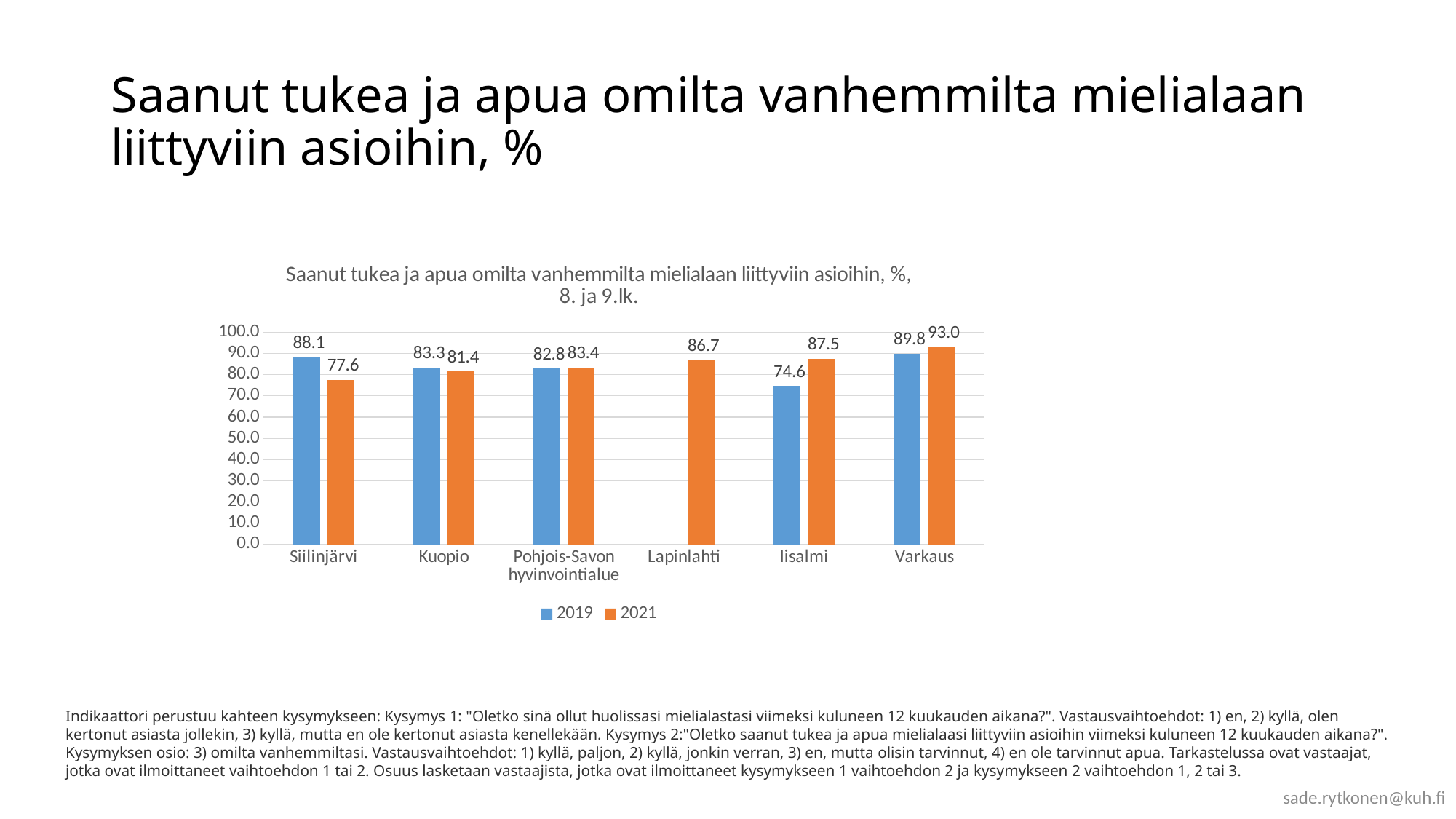
What is the difference between the 2021 and 2019 values for Iisalmi? 12.9 Which category has only a 2021 bar and no 2019 bar? Lapinlahti Which is larger for Kuopio, the 2019 value or the 2021 value? 2019 What is the 2021 value for Lapinlahti? 86.7 How many categories are shown on the x axis? 6 How many series does the legend list? 2 Which category has the lowest 2019 value? Iisalmi What is the 2021 value for Iisalmi? 87.5 Which category has the highest 2021 value? Varkaus What kind of chart is shown on the slide? Bar chart What is the 2019 value for Siilinjärvi? 88.1 What is the difference between the 2019 and 2021 values for Siilinjärvi? 10.5